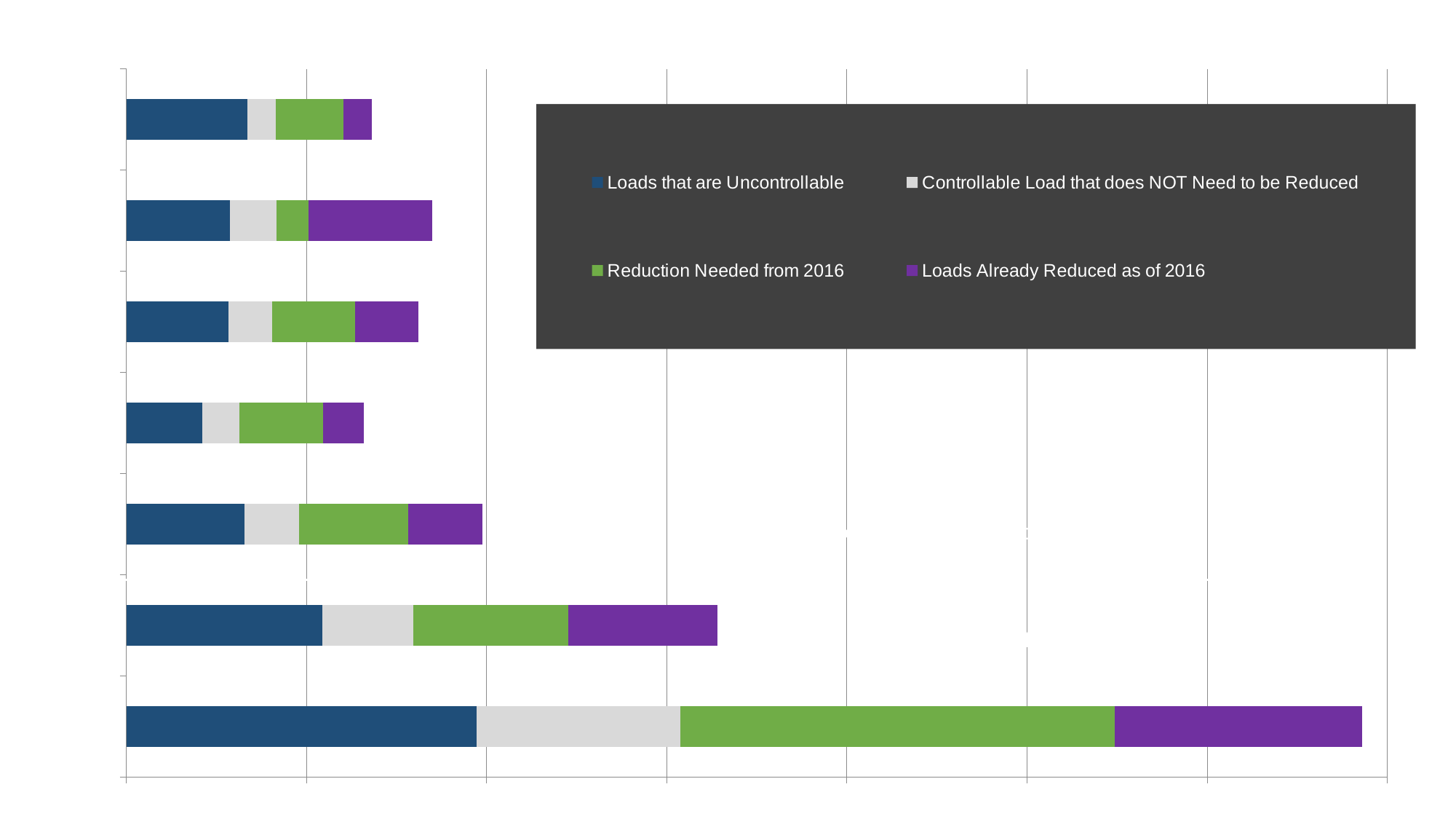
What kind of chart is shown on the slide? Stacked bar chart In the bottom bar, which segment is longer: Reduction Needed from 2016 or Controllable Load that does NOT Need to be Reduced? Reduction Needed from 2016 In the second bar from the top, which segment is longer: Loads Already Reduced as of 2016 or Reduction Needed from 2016? Loads Already Reduced as of 2016 Which series is shown in dark blue in the legend? Loads that are Uncontrollable Is the total of the bottom bar larger or smaller than the total of the bar directly above it? Larger How many series does the legend list? 4 Which bar has the largest total length? The bottom bar Which series is shown in purple in the legend? Loads Already Reduced as of 2016 How many stacked bars are plotted in the chart? 7